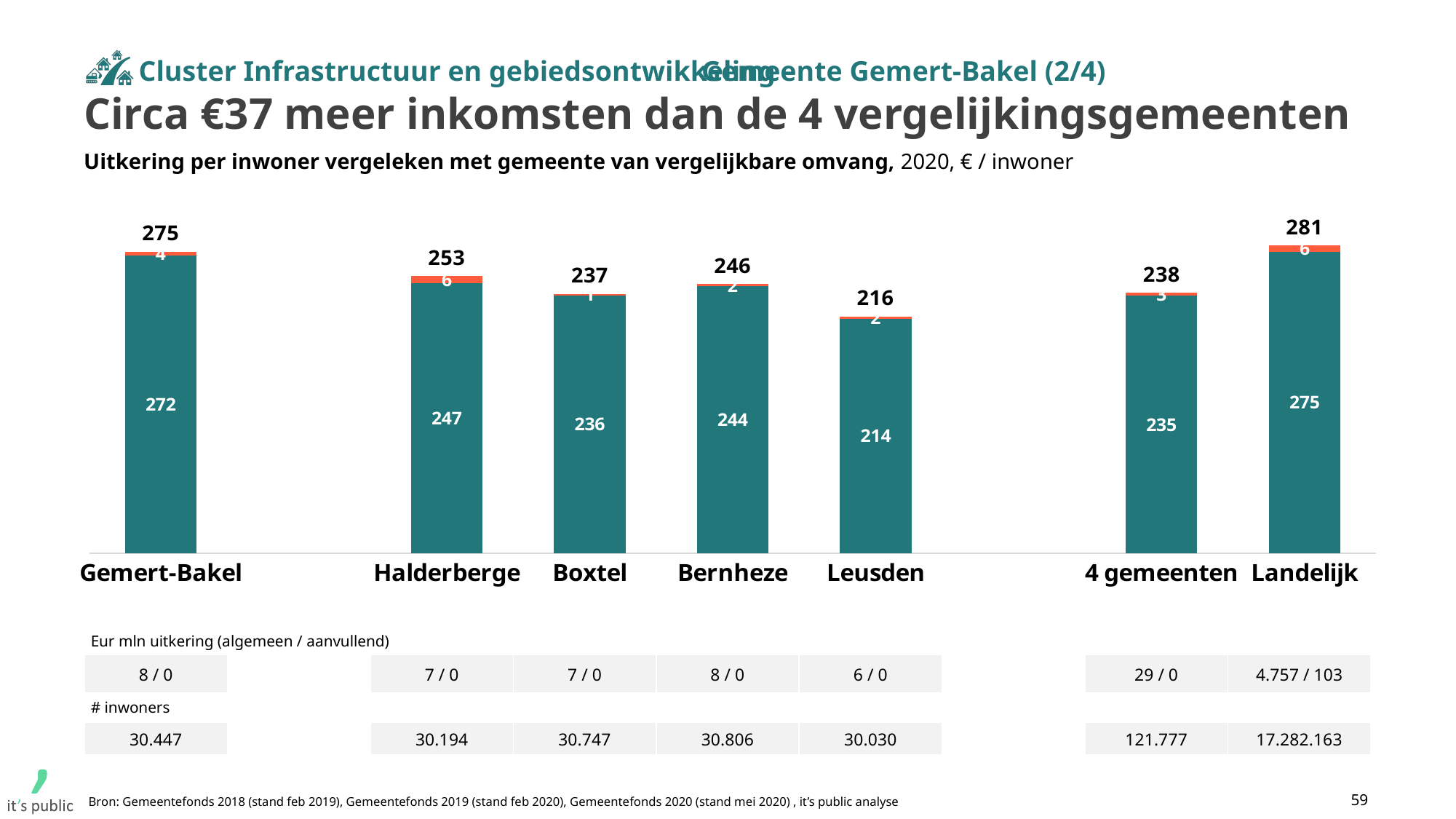
What kind of chart is shown on the slide? Stacked bar chart What is the value of the teal segment for Landelijk? 275 Which category has the highest total value? Landelijk What is the difference between the total for Landelijk and the total for Leusden? 65 What is the total value shown above the bar for Gemert-Bakel? 275 Which category has the lowest total value? Leusden Which has a larger total, Halderberge or Bernheze? Halderberge What is the value of the large teal segment for Halderberge? 247 What is the difference between the total for Gemert-Bakel and the total for 4 gemeenten? 37 How many categories are shown on the x axis of the chart? 7 What is the total value shown above the bar for Leusden? 216 What is the total value shown above the bar for Boxtel? 237